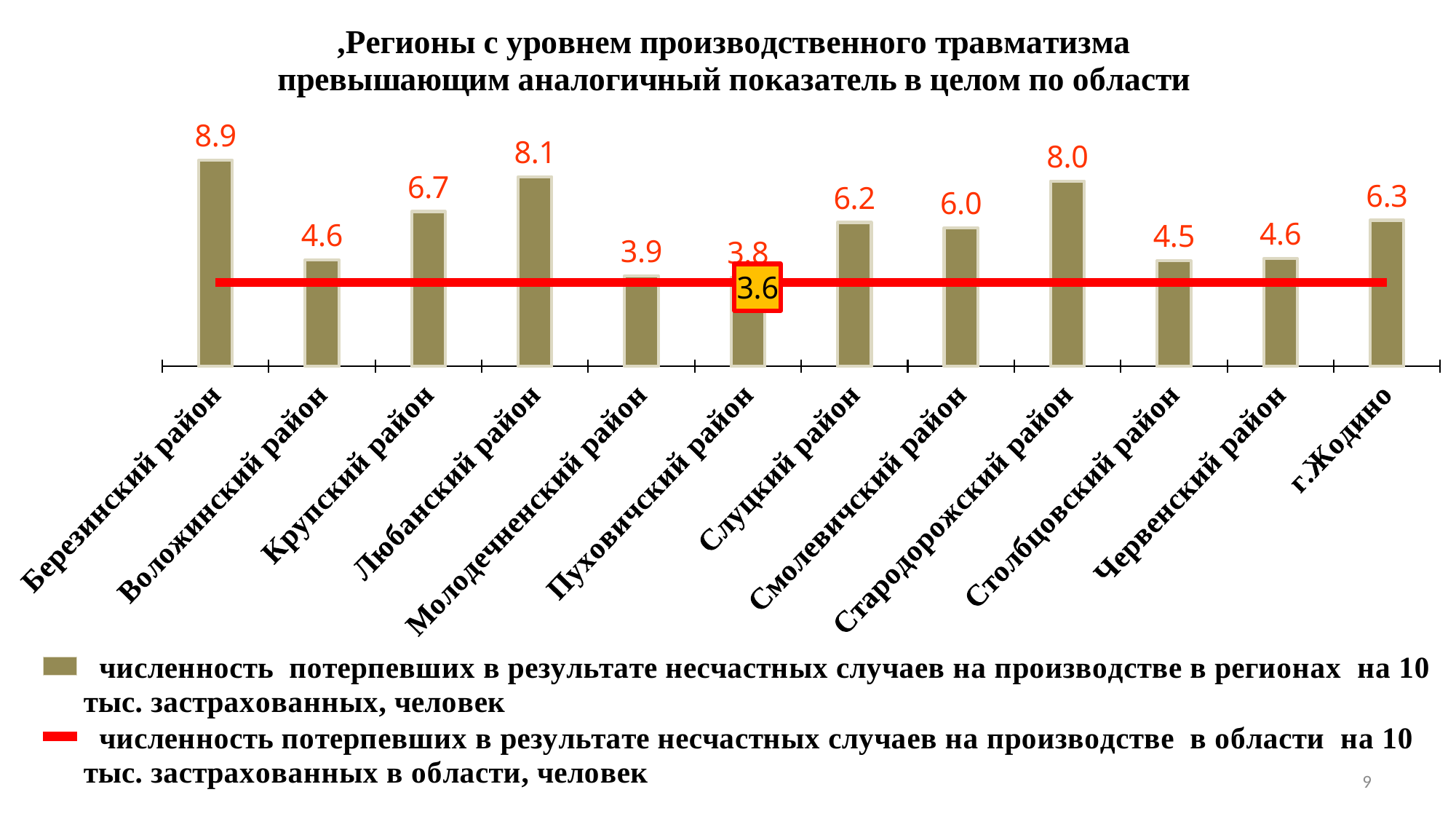
What is the difference between the values for Березинский район and Любанский район? 0.8 How many series does the legend list? 2 Which region has the lowest value? Пуховичский район What kind of chart is shown on the slide? combination bar and line chart What is the value for Березинский район? 8.9 What is the difference between the value for Слуцкий район and the regional average shown on the red line? 2.6 Which is larger, the value for Крупский район or the value for Смолевичский район? Крупский район What is the value for г.Жодино? 6.3 What is the value for Стародорожский район? 8.0 How many regions are shown on the chart? 12 What value is shown on the red line for the region as a whole (область)? 3.6 Which region has the highest value? Березинский район